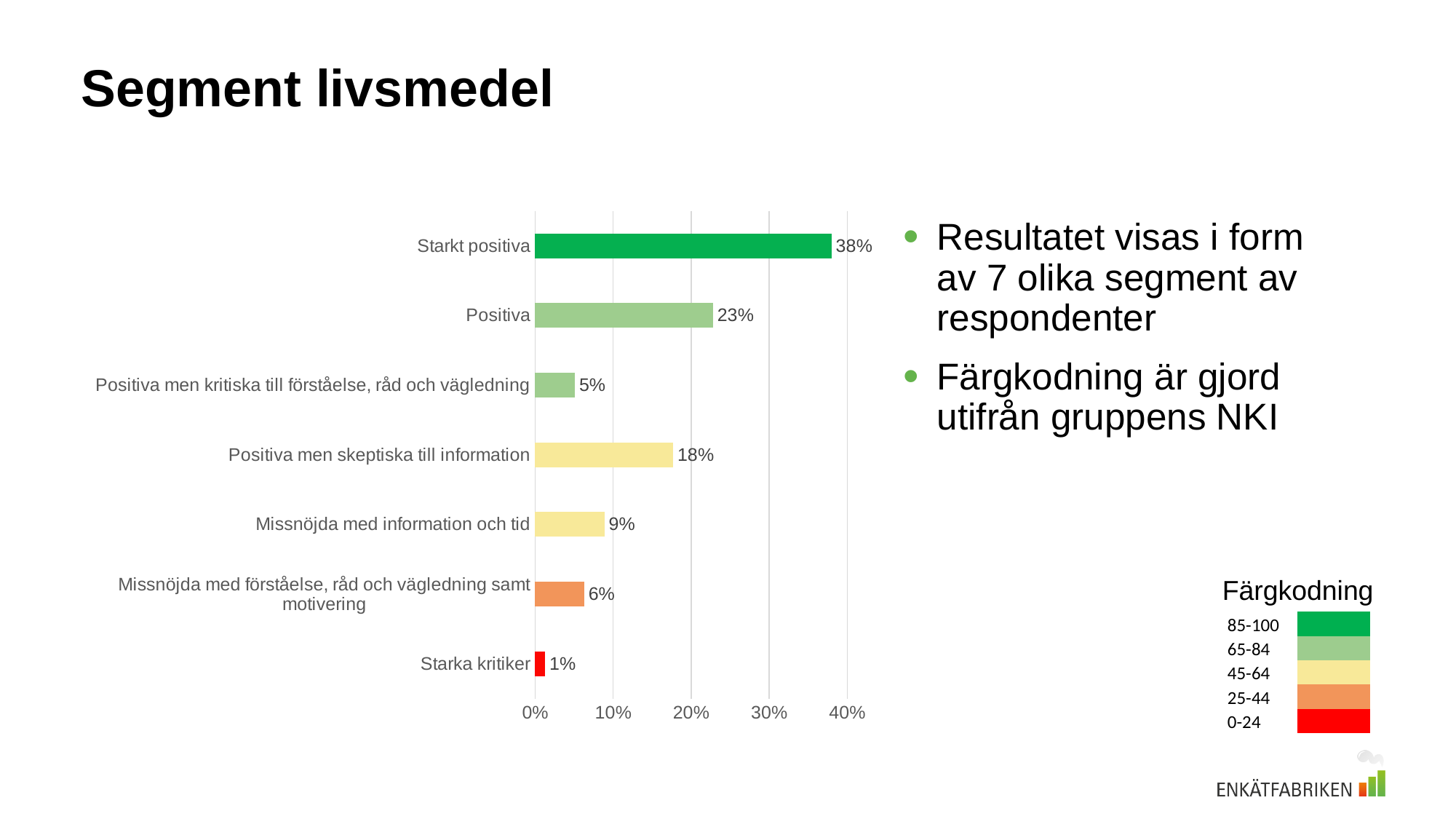
What kind of chart is shown on the slide? Bar chart What is the value for Starka kritiker? 1% How many categories are shown in the chart? 7 Is the value for Positiva greater or less than 20%? greater What colour is the bar for Starka kritiker? Red What is the value for Positiva men skeptiska till information? 18% What is the value for Starkt positiva? 38% What is the value for Missnöjda med information och tid? 9% Which category has the highest value? Starkt positiva Which is larger, Positiva men kritiska till förståelse, råd och vägledning or Missnöjda med förståelse, råd och vägledning samt motivering? Missnöjda med förståelse, råd och vägledning samt motivering What is the difference between Starkt positiva and Positiva? 15% Which category has the lowest value? Starka kritiker